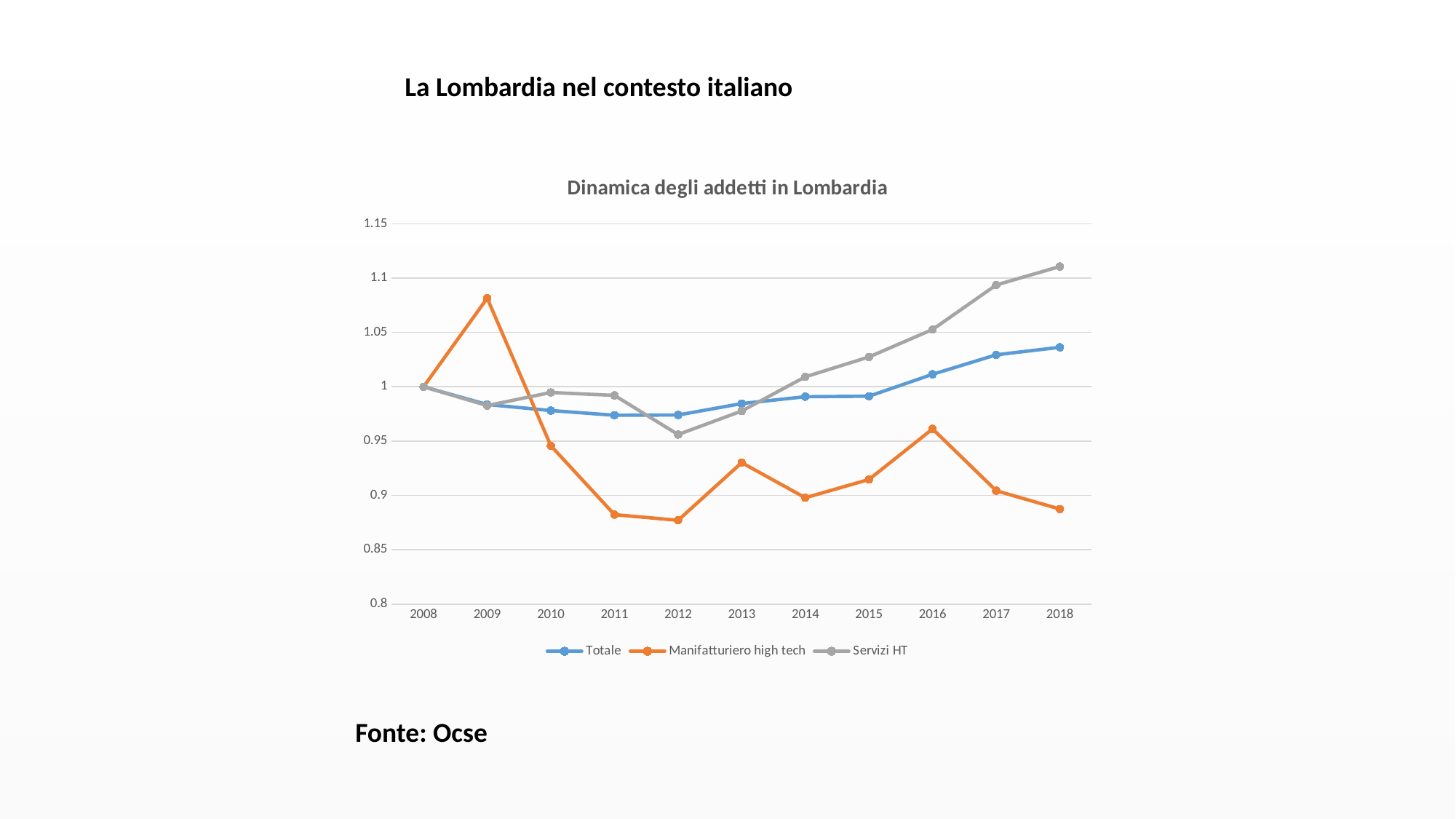
In which year does the Manifatturiero high tech series reach its highest value? 2009 Is the value for Manifatturiero high tech in 2012 greater or less than 0.9? less How many years are shown on the x axis? 11 Is the value for Manifatturiero high tech in 2009 greater or less than 1.05? greater Is the value for Totale in 2018 greater or less than 1.05? less In which year does the Servizi HT series reach its lowest value? 2012 In 2018, which series has the larger value, Servizi HT or Totale? Servizi HT Does the Servizi HT series rise or fall from 2013 to 2018? rise In which year does the Servizi HT series reach its highest value? 2018 What kind of chart is shown on the slide? line chart What is the value of the Totale series in 2008? 1 How many series does the legend list? 3